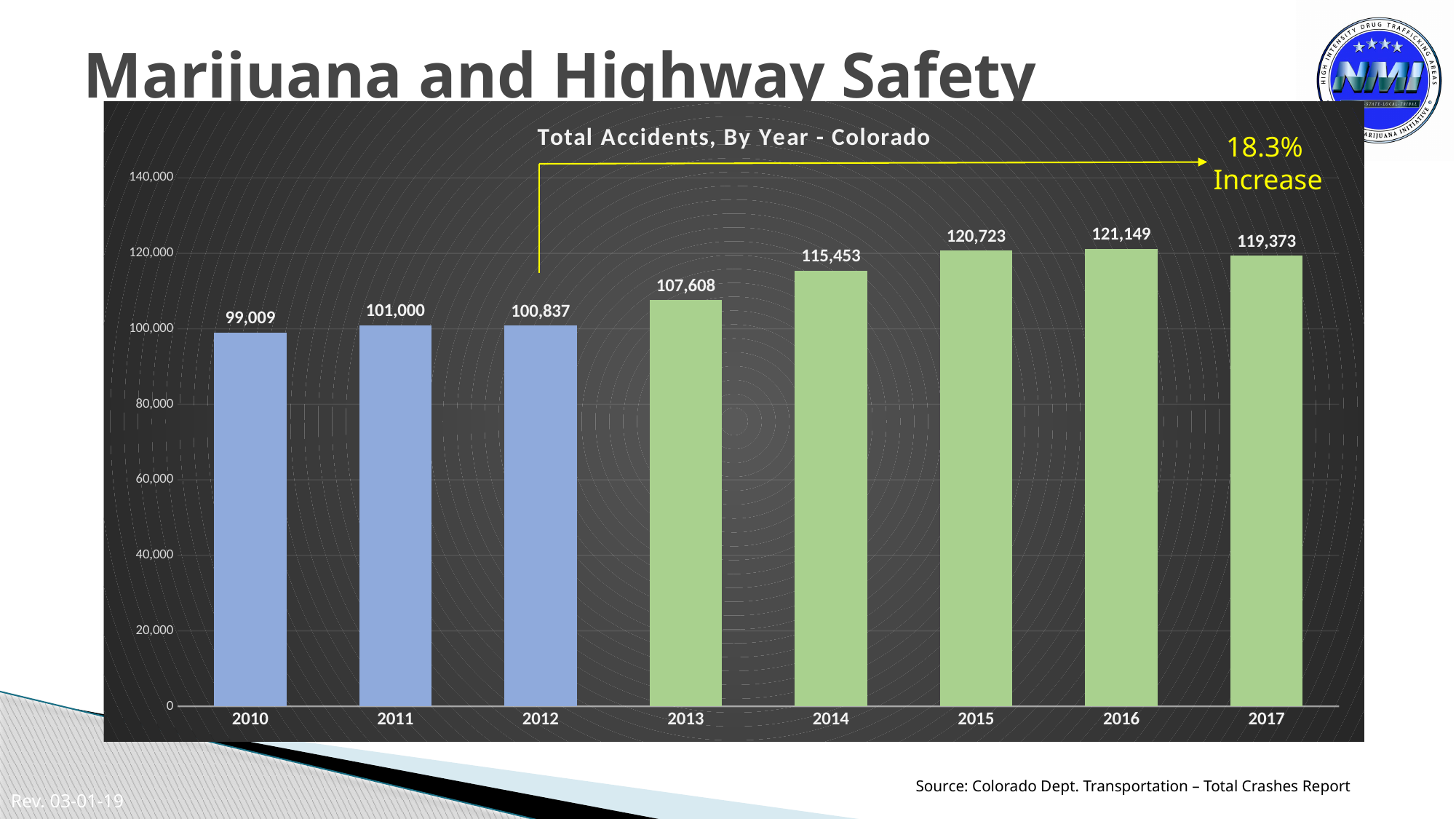
What kind of chart is the Total Accidents, By Year - Colorado chart? bar chart Which year has the highest value in the Total Accidents, By Year - Colorado chart? 2016 Which is larger in the Total Accidents, By Year - Colorado chart, the value for 2013 or the value for 2015? 2015 What is the difference between the values for 2017 and 2010 in the Total Accidents, By Year - Colorado chart? 20,364 What is the value for 2010 in the Total Accidents, By Year - Colorado chart? 99,009 What is the value for 2017 in the Total Accidents, By Year - Colorado chart? 119,373 What percentage increase is annotated on the Total Accidents, By Year - Colorado chart? 18.3% How many years are shown in the Total Accidents, By Year - Colorado chart? 8 What is the difference between the values for 2014 and 2013 in the Total Accidents, By Year - Colorado chart? 7,845 Which year has the lowest value in the Total Accidents, By Year - Colorado chart? 2010 What is the value for 2014 in the Total Accidents, By Year - Colorado chart? 115,453 Is the value for 2013 in the Total Accidents, By Year - Colorado chart greater or less than 100,000? greater